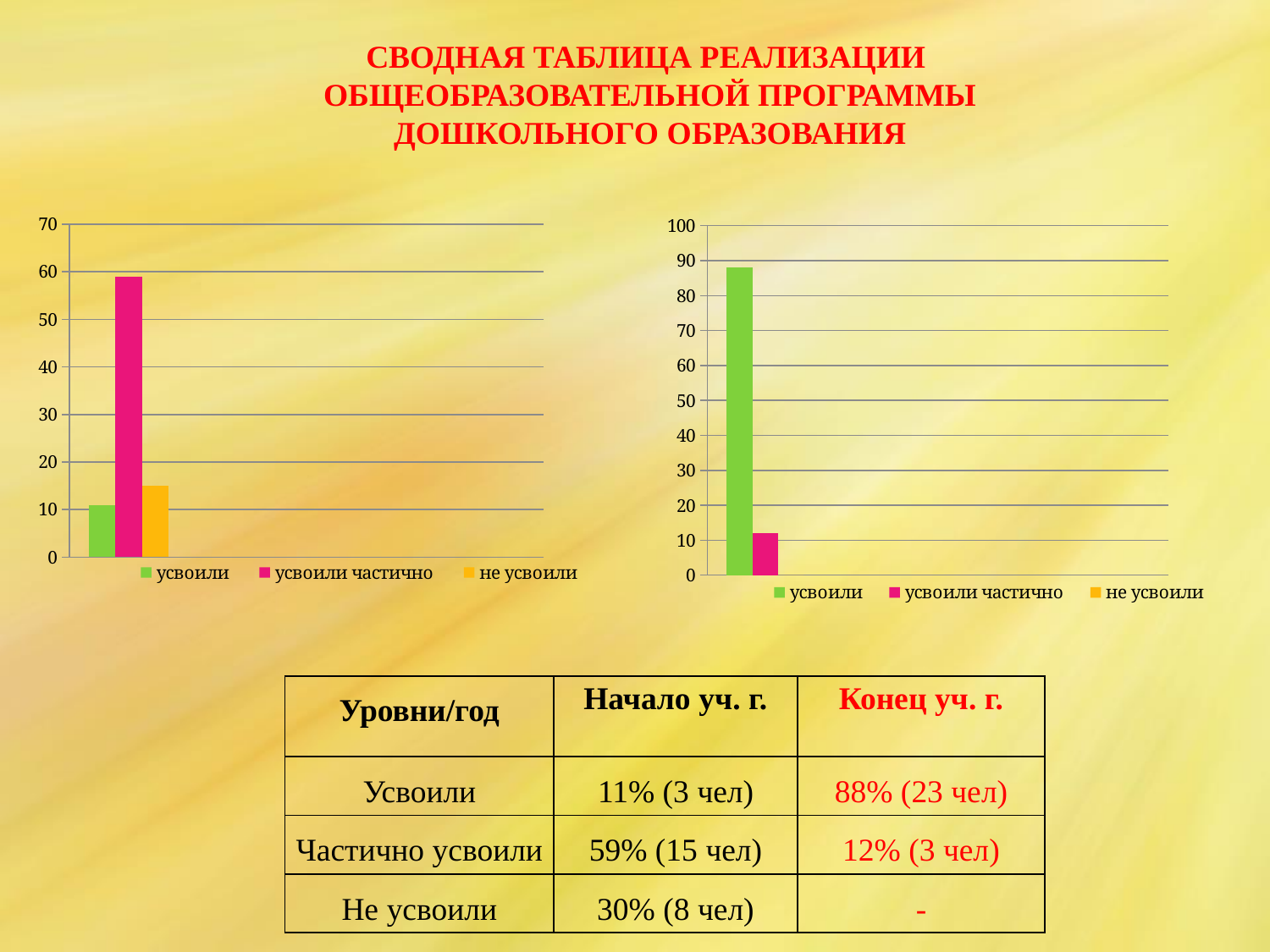
In the right chart, which series has the tallest bar? усвоили In the left chart, which series has the tallest bar? усвоили частично In the left chart, is the value for усвоили greater or less than 20? less How many series does the legend of the left chart list? 3 In the left chart, is the value for усвоили частично greater or less than 50? greater In the right chart, which is larger: усвоили or усвоили частично? усвоили What kind of chart is the right chart? bar chart In the right chart, is the value for усвоили greater or less than 80? greater What is the highest value shown on the vertical axis of the right chart? 100 In the left chart, which series has the shortest bar? усвоили